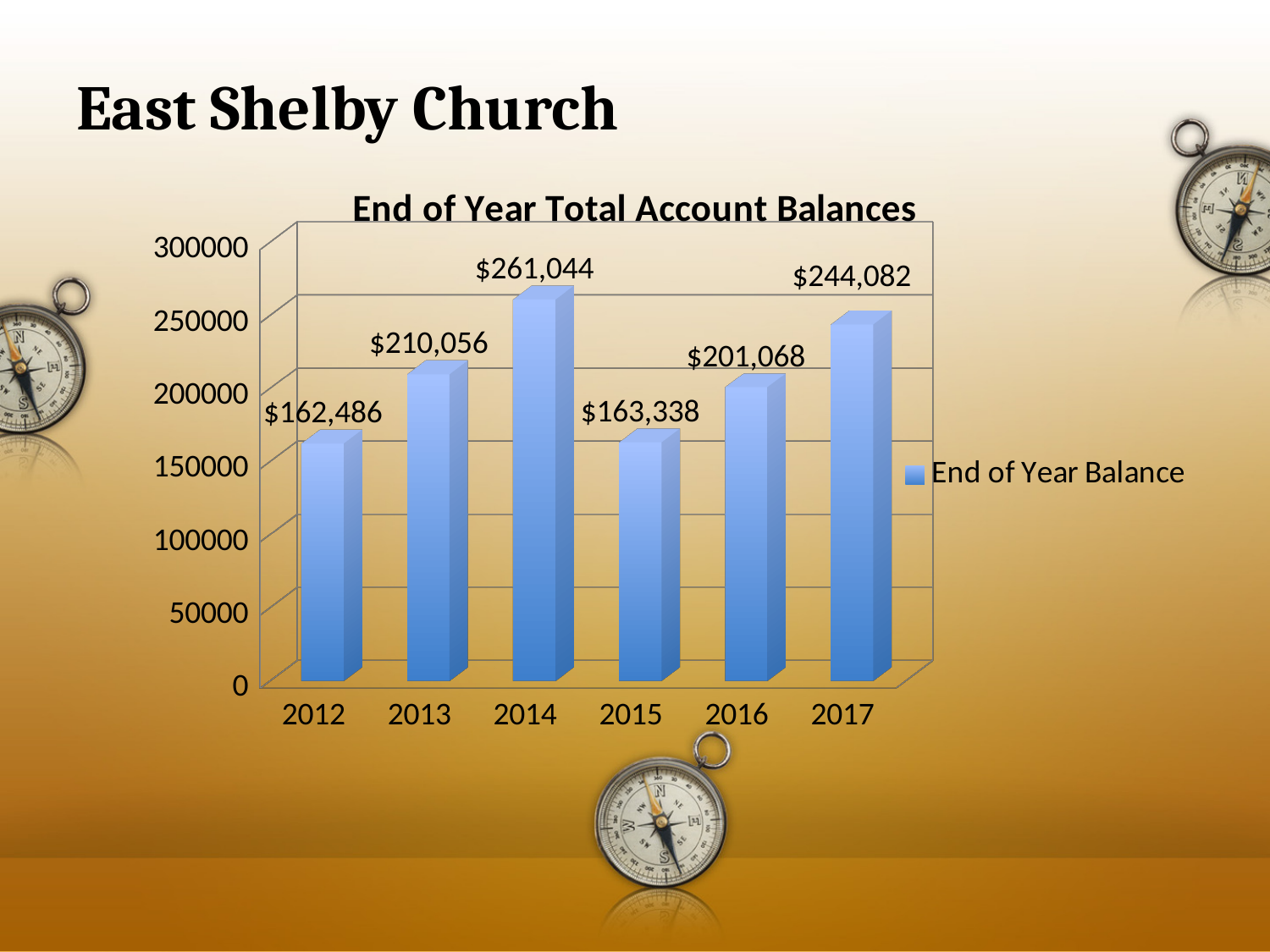
What is the title of the chart? End of Year Total Account Balances What is the End of Year Balance for 2012? $162,486 What kind of chart is shown on the slide? bar chart Which year has the lowest End of Year Balance? 2012 Is the End of Year Balance for 2016 greater or less than 250000? less What is the difference between the End of Year Balance for 2017 and 2016? $43,014 Which year has the highest End of Year Balance? 2014 Which year has a larger End of Year Balance, 2013 or 2017? 2017 What is the difference between the End of Year Balance for 2014 and 2012? $98,558 What is the End of Year Balance for 2014? $261,044 What is the End of Year Balance for 2017? $244,082 How many years are shown on the x axis of the chart? 6